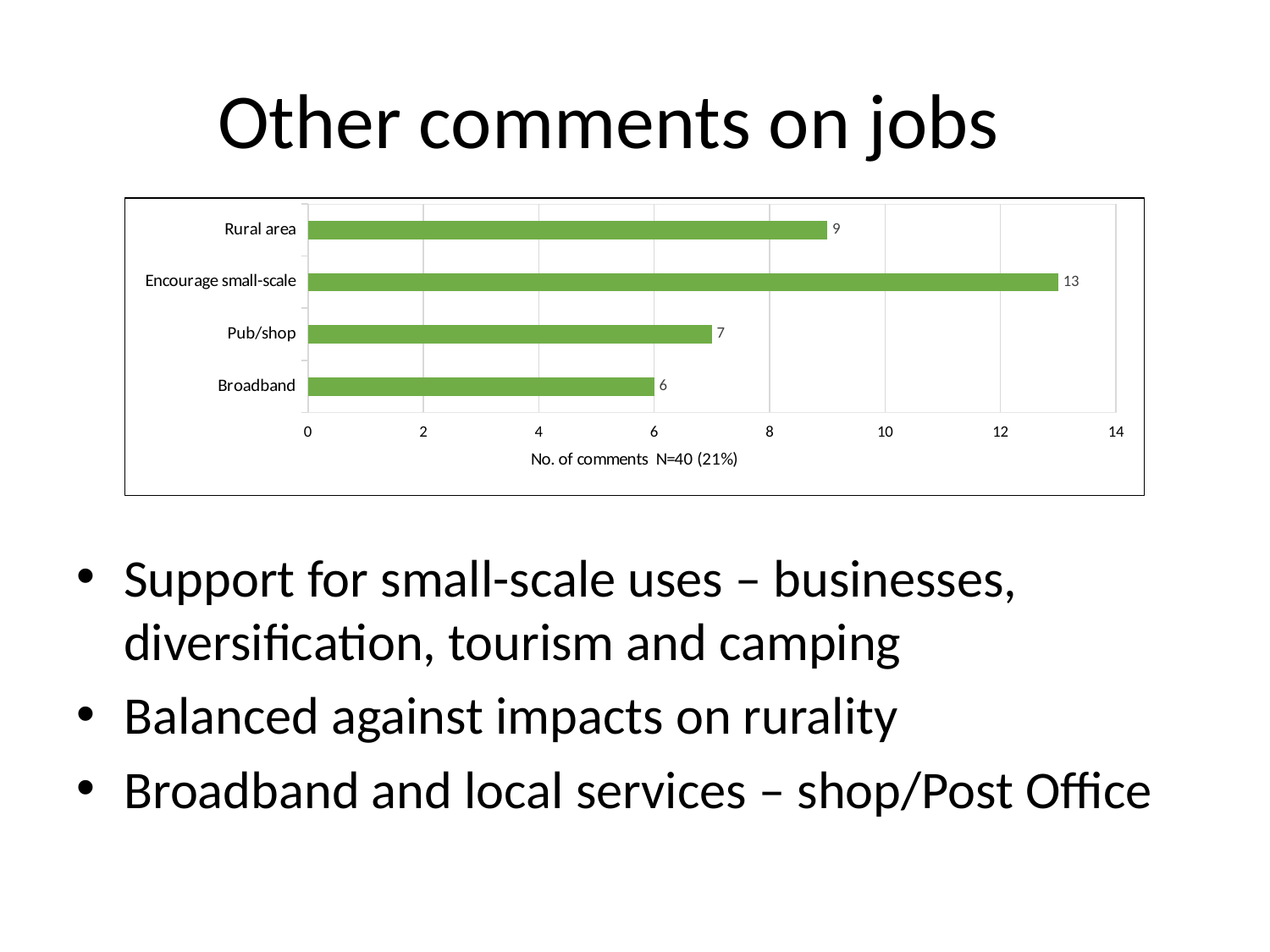
Which category has the highest number of comments? Encourage small-scale How many comments are shown for Encourage small-scale? 13 What is the difference in comments between Encourage small-scale and Rural area? 4 What is the label on the horizontal axis of the chart? No. of comments N=40 (21%) How many comments are shown for Broadband? 6 How many categories are shown in the chart? 4 What kind of chart is shown on the slide? Bar chart How many comments are shown for Pub/shop? 7 Is the value for Rural area greater or less than 8? greater Which has more comments, Pub/shop or Broadband? Pub/shop Which category has the lowest number of comments? Broadband How many comments are shown for Rural area? 9